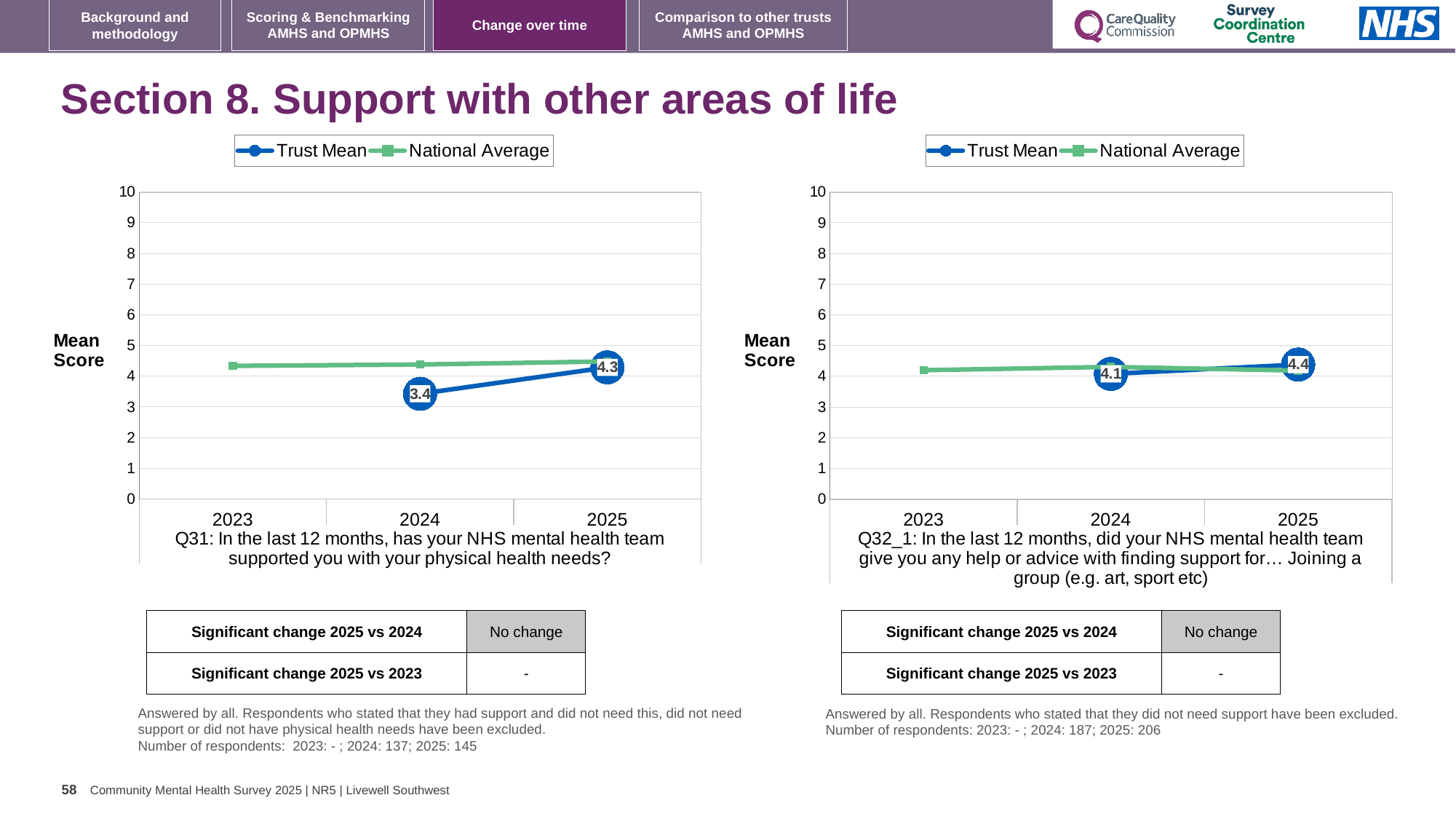
On the right chart (Q32_1), which year has the higher Trust Mean, 2024 or 2025? 2025 On the left chart (Q31), what is the Trust Mean value for 2025? 4.3 On the left chart (Q31), by how much did the Trust Mean change from 2024 to 2025? 0.9 On the left chart (Q31), what is the Trust Mean value for 2024? 3.4 On the right chart (Q32_1), what is the Trust Mean value for 2025? 4.4 On the left chart (Q31), does the Trust Mean rise or fall from 2024 to 2025? rise How many years are shown on the x axis of the left chart (Q31)? 3 On the right chart (Q32_1), what is the Trust Mean value for 2024? 4.1 What type of chart is the left chart (Q31)? line chart On the right chart (Q32_1), what is the difference between the Trust Mean in 2025 and in 2024? 0.3 On the left chart (Q31), is the National Average value for 2023 greater or less than 5? less How many series does the legend of the right chart (Q32_1) list? 2